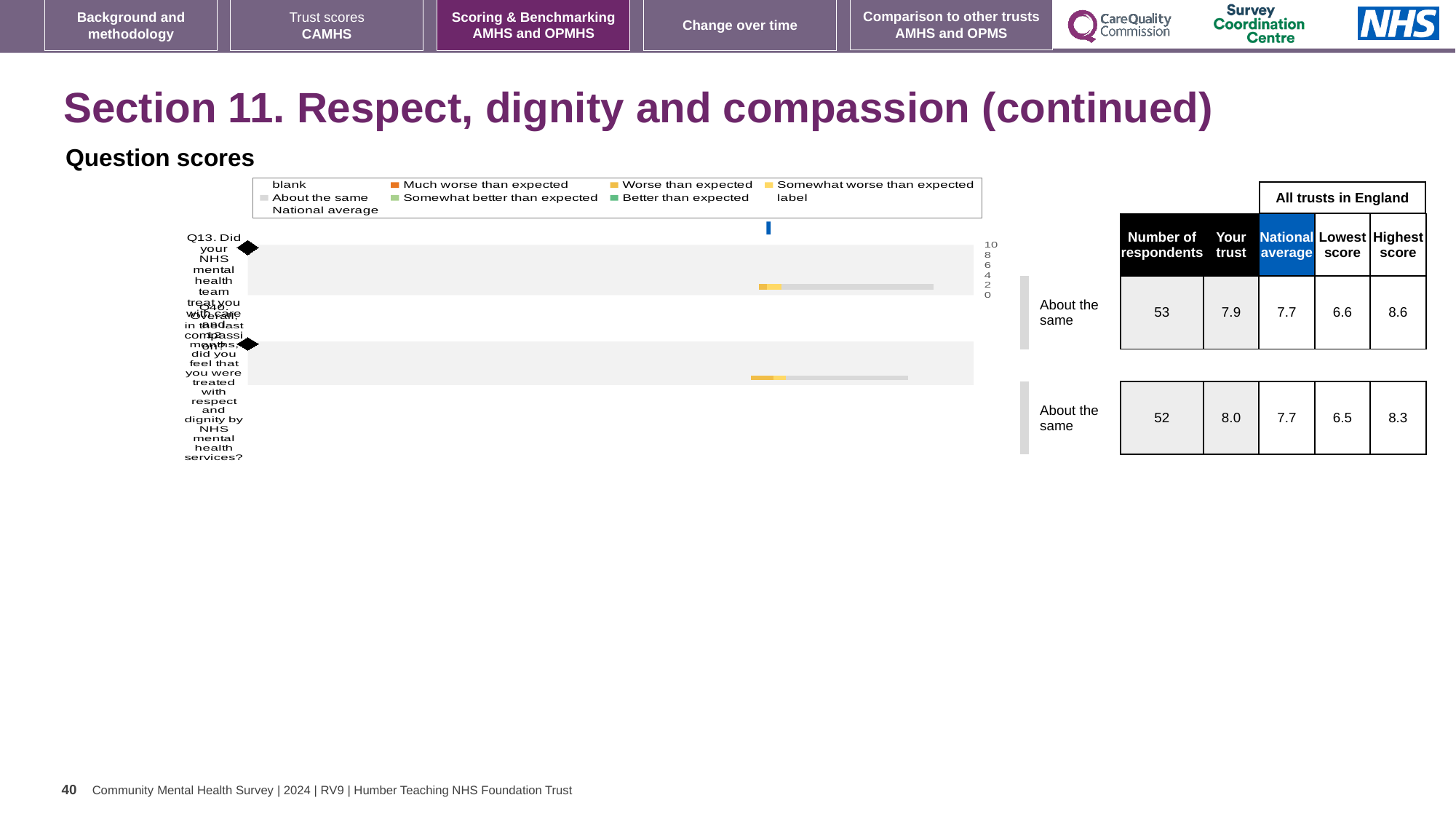
What benchmark category is shown for Q13 compared with other trusts? About the same What is the difference between the highest and lowest trust scores for Q13? 2.0 Which question has the higher 'Your trust' score, Q13 or Q10? Q10 What kind of chart is shown under 'Question scores'? bar chart What is the highest score among all trusts in England for Q13? 8.6 How many questions (categories) are plotted in the chart? 2 What is the maximum value shown on the chart's score axis? 10 What is the national average score shown for Q13? 7.7 How many respondents answered Q10? 52 By how much does the 'Your trust' score for Q10 exceed the national average? 0.3